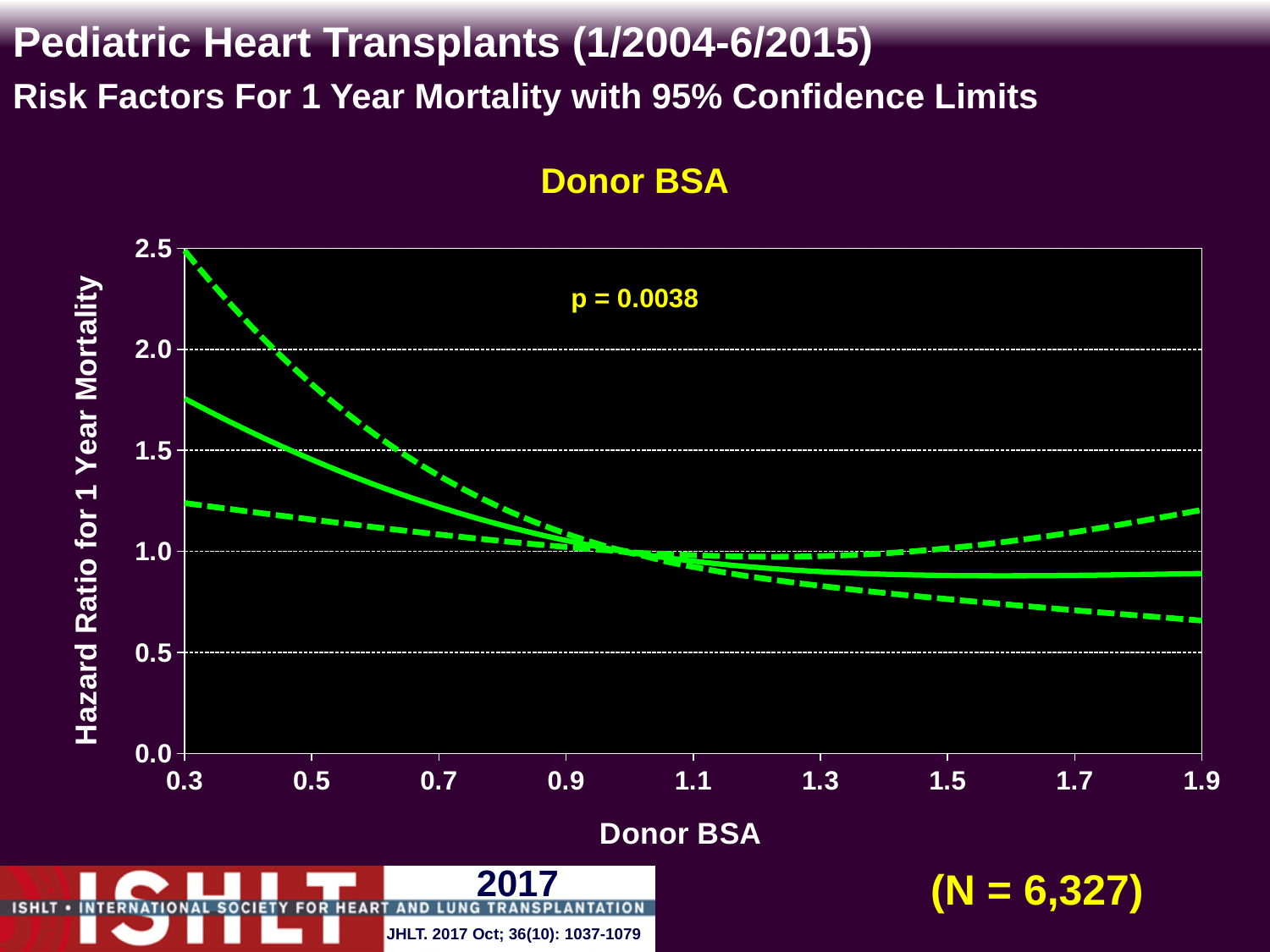
Which is larger for the solid line: the hazard ratio at Donor BSA 0.3 or at Donor BSA 1.9? 0.3 Is the solid hazard ratio line at Donor BSA 0.3 greater or less than 1.5? greater Is the solid hazard ratio line at Donor BSA 1.9 greater or less than 1.0? less Is the lower dashed confidence limit at Donor BSA 1.9 greater or less than 0.5? greater What kind of chart is shown on the slide? Line chart What p-value is printed on the chart? p = 0.0038 How many lines are plotted on the chart? 3 Does the solid hazard ratio line rise or fall as Donor BSA increases from 0.3 to 1.1? Fall What is the sample size (N) shown on the slide? 6,327 What is the title of the chart? Donor BSA What is the label of the y axis? Hazard Ratio for 1 Year Mortality